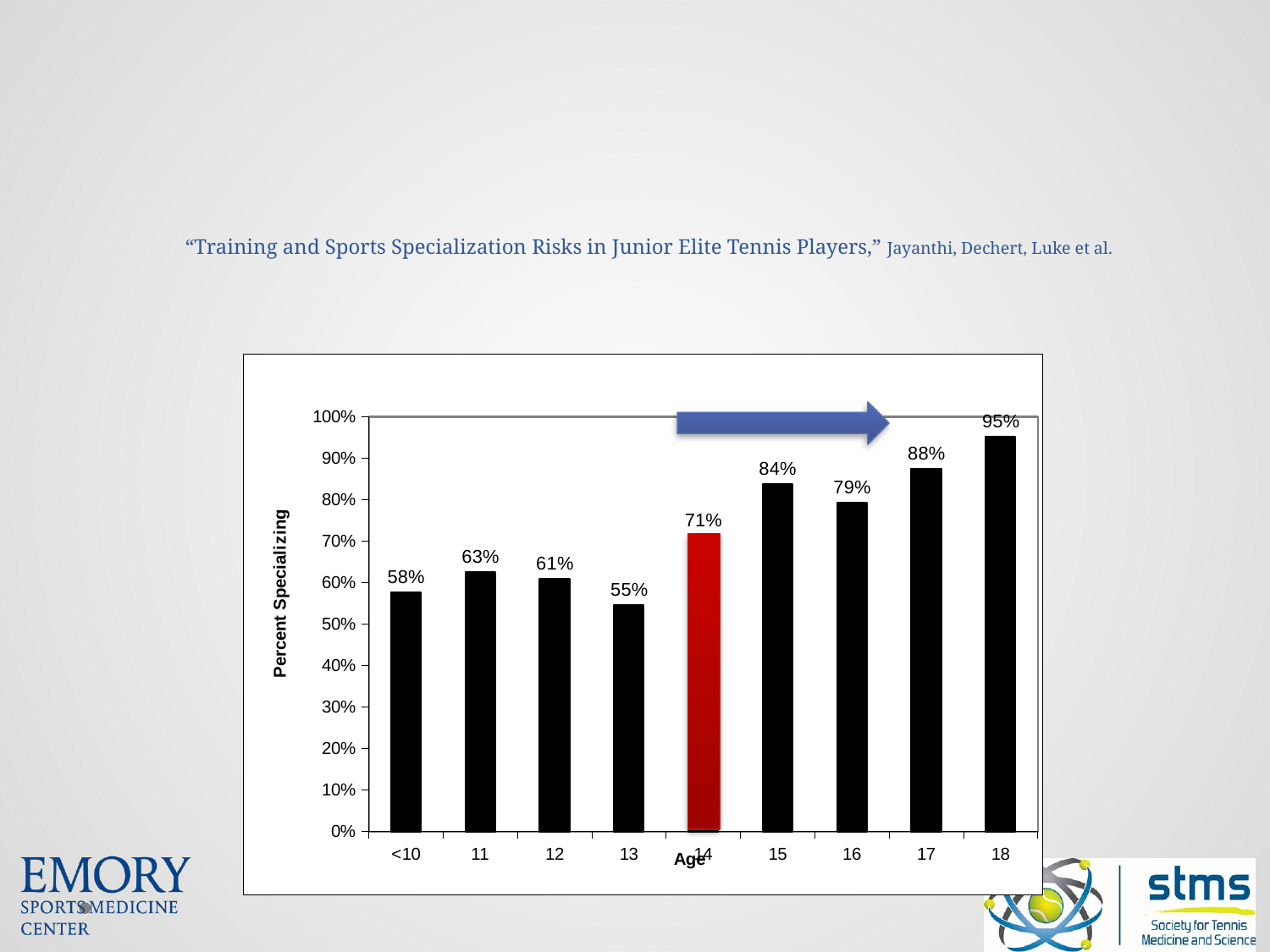
Is the value for age 17 greater or less than 80%? greater Which age group has the highest percent specializing? 18 How many age categories are shown on the x axis? 9 What is the percent specializing for age 14? 71% Which bar is highlighted in red? 14 What is the difference in percent specializing between age 15 and age 16? 5% What is the percent specializing for age 16? 79% Which age group has the lowest percent specializing? 13 What is the difference in percent specializing between age 18 and age 13? 40% What kind of chart is shown on the slide? bar chart What is the percent specializing for age <10? 58% Which has a higher percent specializing, age 11 or age 12? 11